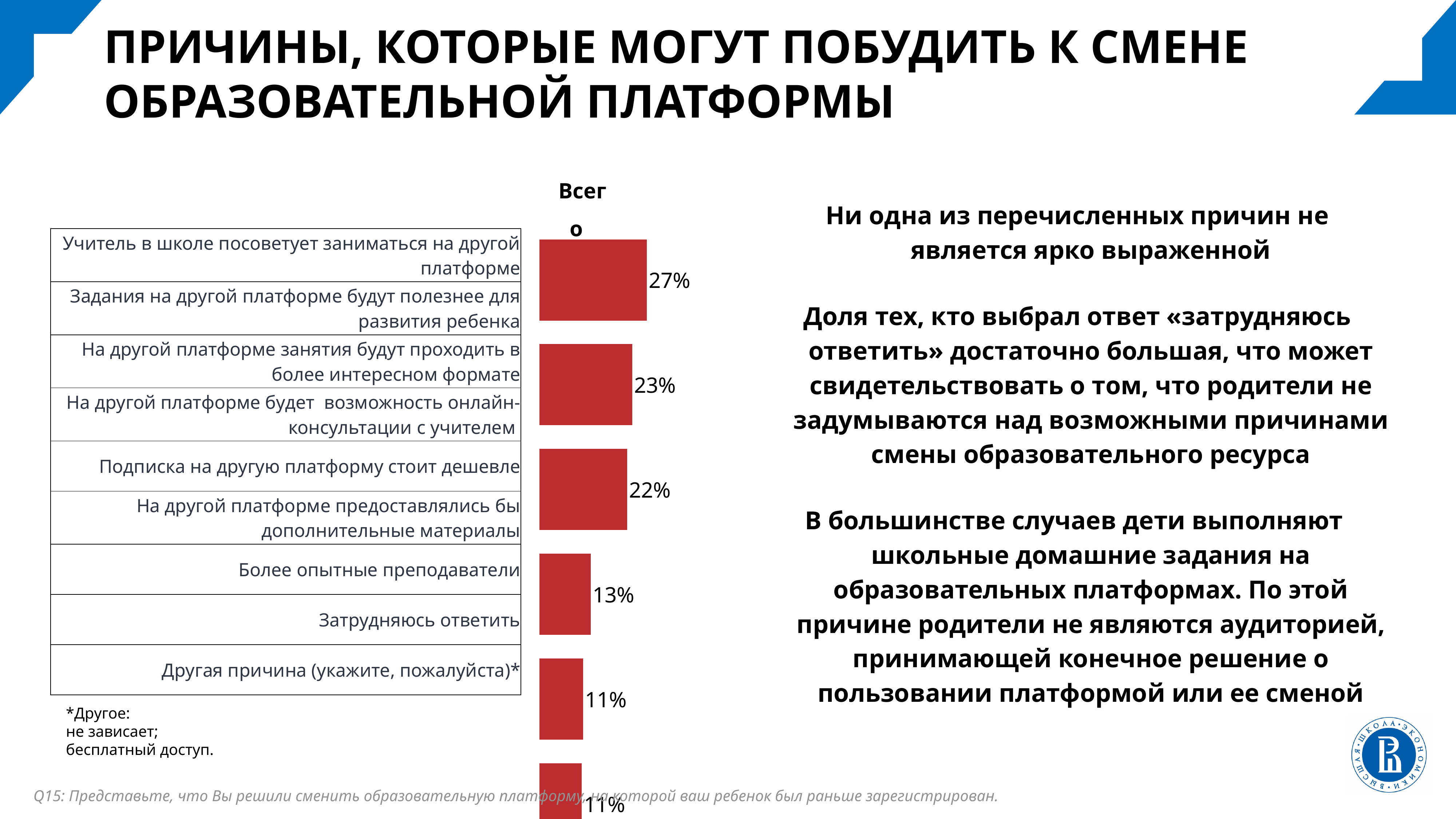
What is the difference between the bar labelled 27% and the bar labelled 23%? 4% What is the lowest value printed on the bars of the chart? 11% How many data labels are visible on the bars of the chart? 6 What is the highest value printed on the bars of the chart? 27% What is the difference between the highest printed bar value (27%) and the lowest printed bar value (11%)? 16% What kind of chart is shown on the slide? bar chart What colour are the bars in the chart? red What is the column header printed above the bars? Всего How many bars in the chart are labelled 11%? 2 Which is larger, the bar labelled 23% or the bar labelled 22%? 23%